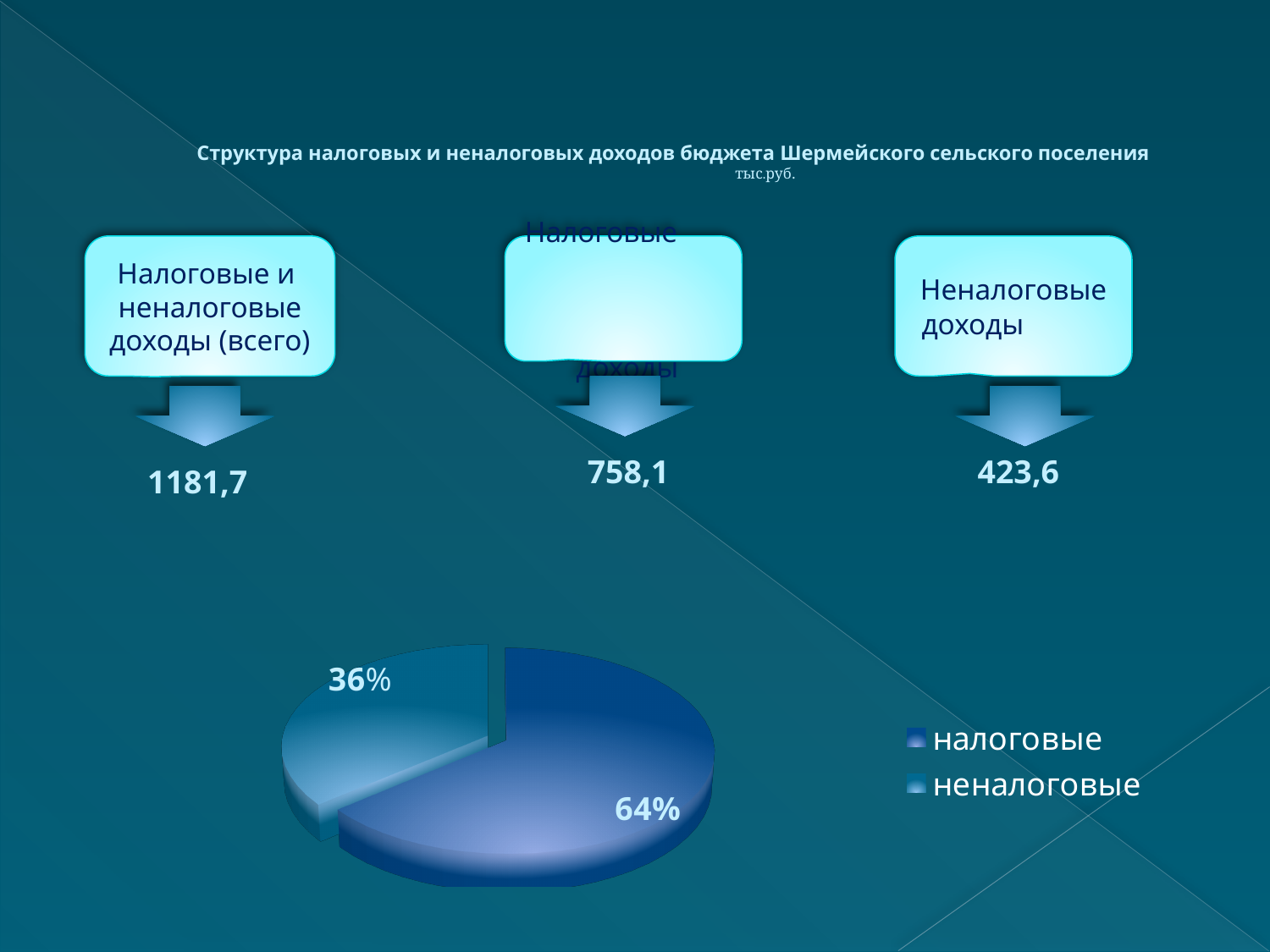
Which slice of the pie chart is the largest? налоговые How many slices does the pie chart have? 2 What kind of chart is shown at the bottom of the slide? pie chart What is the second entry listed in the pie chart's legend? неналоговые What is the first entry listed in the pie chart's legend? налоговые How many entries does the pie chart's legend list? 2 Which slice of the pie chart is the smallest? неналоговые What share of the pie chart does the "неналоговые" slice represent? 36% Which is larger in the pie chart: the "налоговые" slice or the "неналоговые" slice? налоговые What share of the pie chart does the "налоговые" slice represent? 64% Is the share of the "неналоговые" slice in the pie chart greater or less than 50%? less By how many percentage points does the "налоговые" slice exceed the "неналоговые" slice in the pie chart? 28